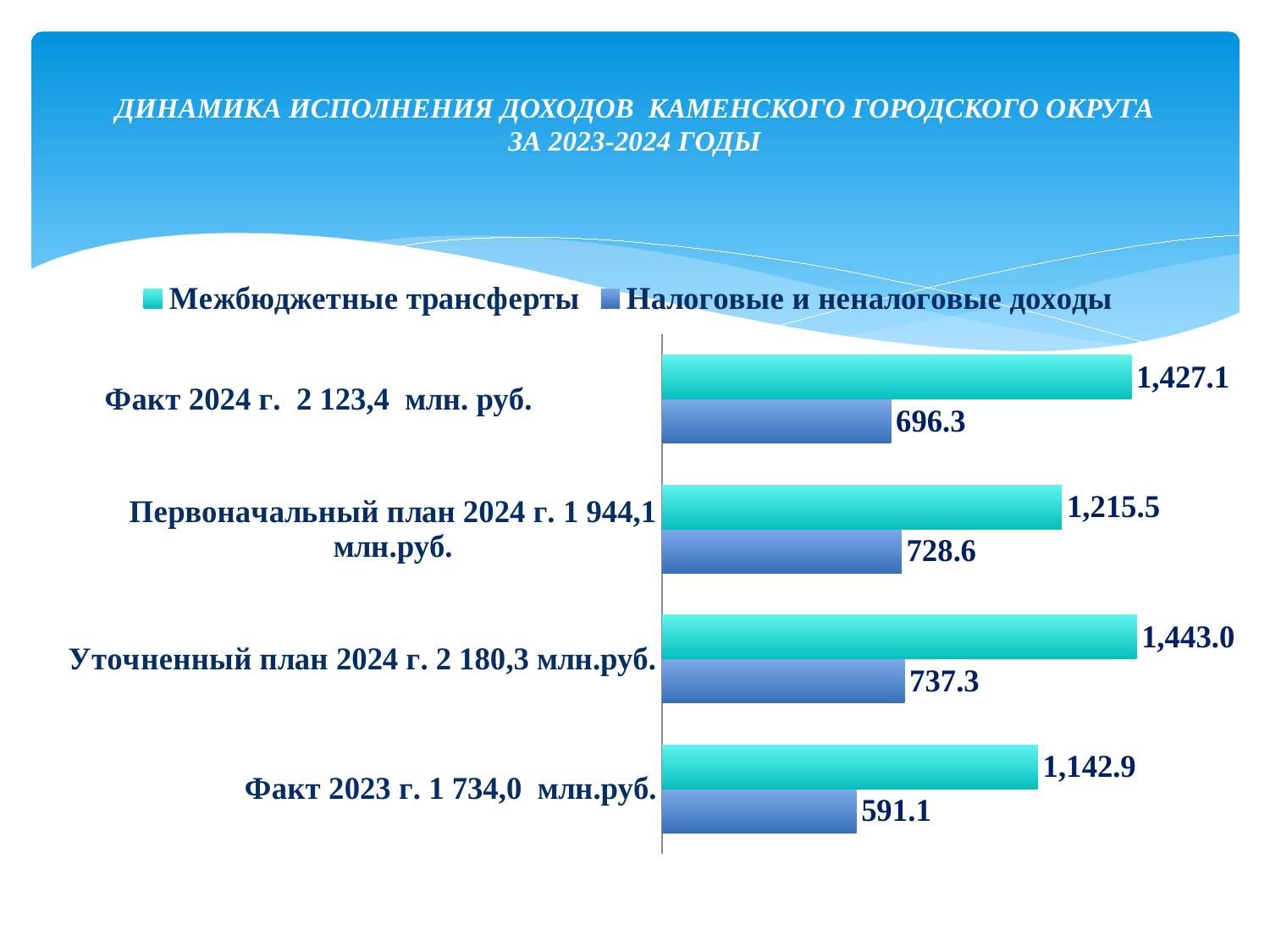
What is the value of Налоговые и неналоговые доходы for Факт 2023 г.? 591.1 How many series does the legend list? 2 How many categories are shown on the chart? 4 What is the difference between Межбюджетные трансферты and Налоговые и неналоговые доходы for Факт 2024 г.? 730.8 What is the value of Межбюджетные трансферты for Первоначальный план 2024 г.? 1,215.5 Which series is shown in turquoise in the legend? Межбюджетные трансферты What is the value of Межбюджетные трансферты for Факт 2024 г.? 1,427.1 What kind of chart is shown on the slide? Bar chart Which is larger: Налоговые и неналоговые доходы for Первоначальный план 2024 г. or for Факт 2024 г.? Первоначальный план 2024 г. What is the value of Налоговые и неналоговые доходы for Уточненный план 2024 г.? 737.3 Which category has the highest value for Межбюджетные трансферты? Уточненный план 2024 г. Which category has the lowest value for Налоговые и неналоговые доходы? Факт 2023 г.